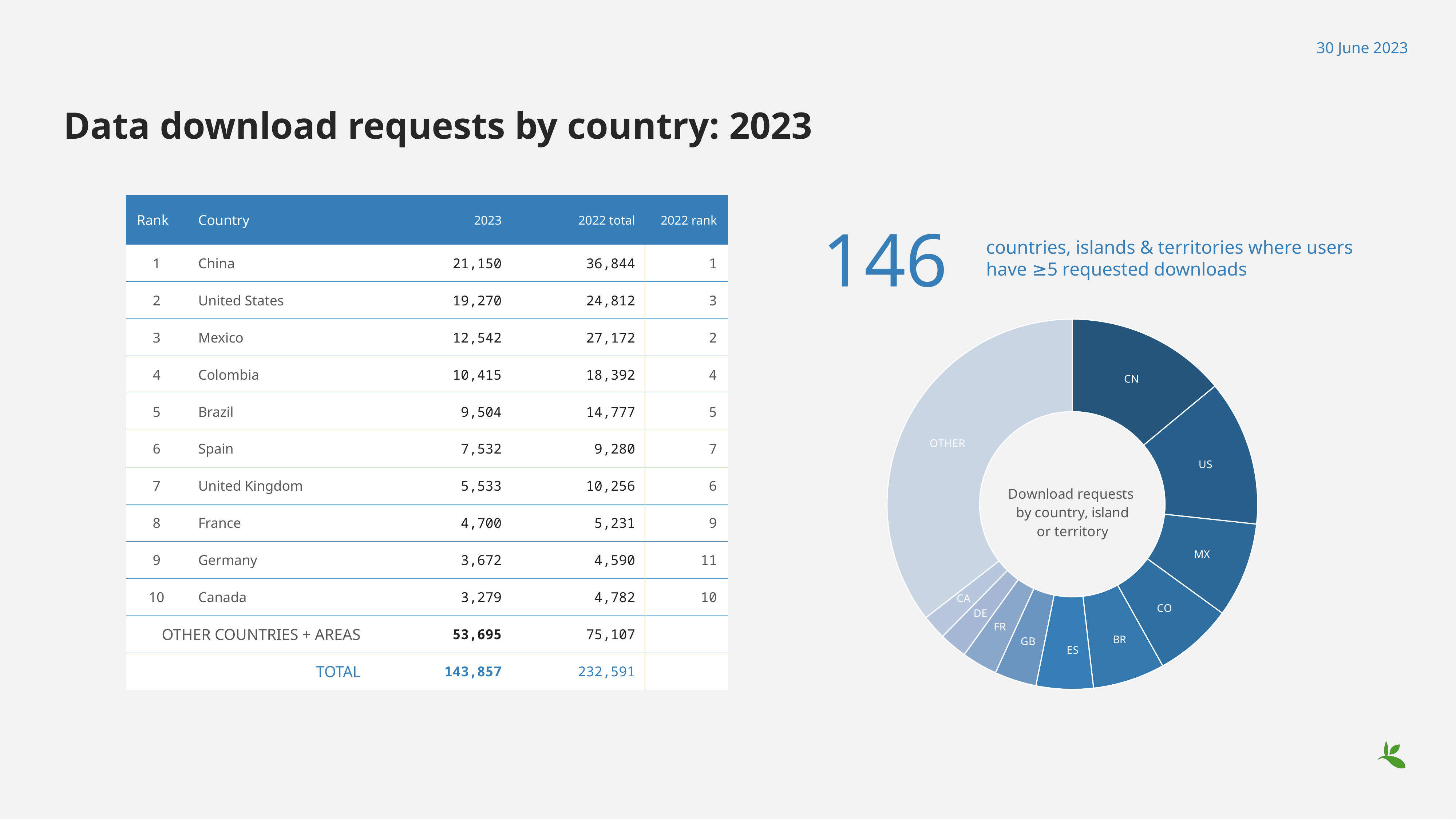
Which slice of the donut chart is the largest? OTHER In the donut chart, which slice is larger, CN or US? CN Which single-country slice of the donut chart is the largest? CN In the donut chart, which slice is larger, MX or CO? MX According to the table, how many 2023 download requests does the CN slice represent? 21,150 What is the difference in 2023 download requests between China and the United States? 1,880 According to the table, how many 2023 download requests does the OTHER slice represent? 53,695 What is the total number of 2023 download requests represented by the donut chart? 143,857 What text is written in the centre of the donut chart? Download requests by country, island or territory What kind of chart is shown on the right of the slide? donut (pie) chart Which slice of the donut chart is the smallest? CA How many slices does the donut chart have? 11